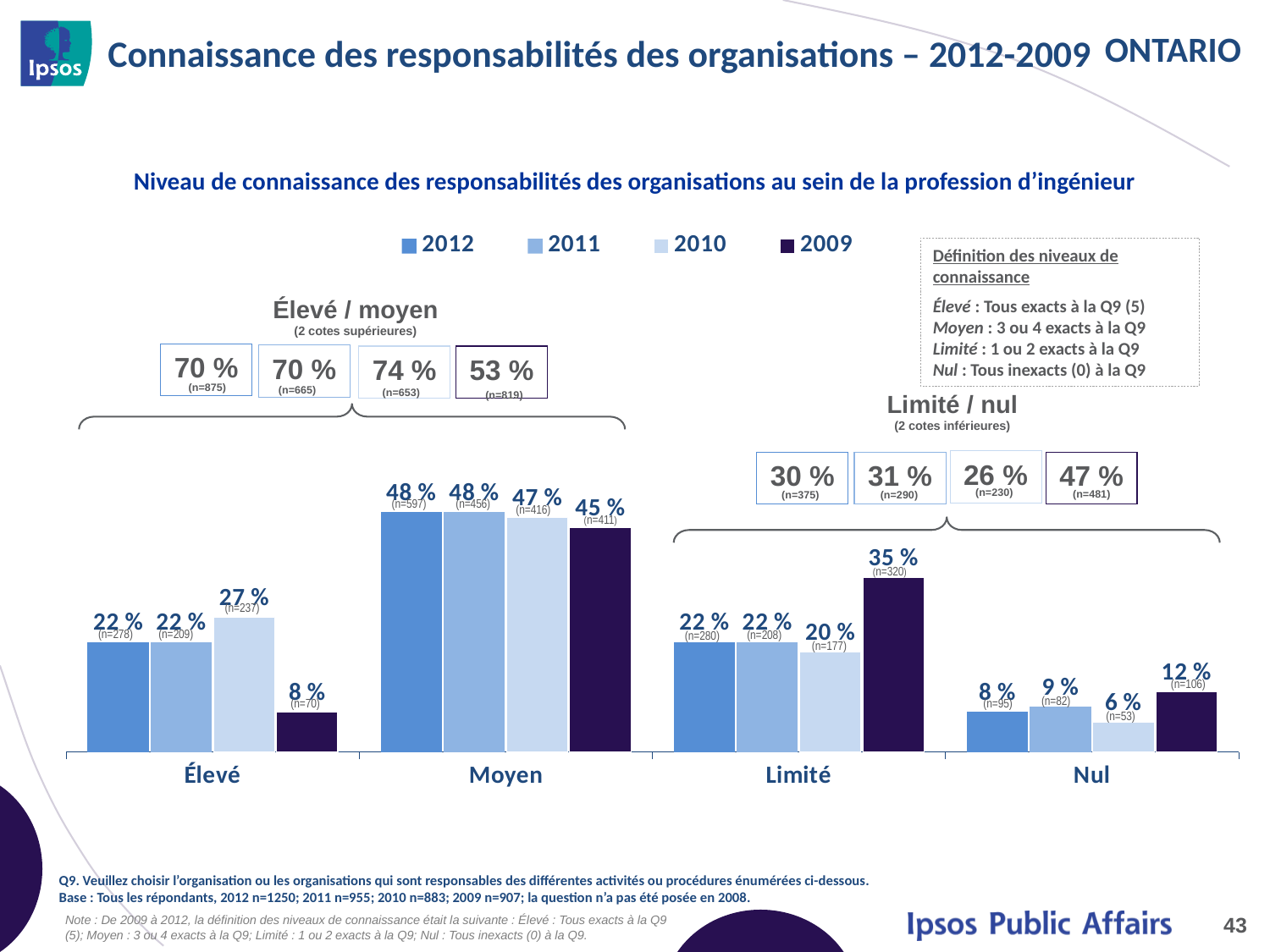
What is the difference between the 2009 and 2010 values in the Limité category? 15 % What is the 2009 value shown in the Limité / nul summary box? 47 % Which year has the highest value in the Nul category? 2009 What is the value for 2009 in the Limité category? 35 % How many series does the legend list? 4 What is the value for 2010 in the Nul category? 6 % How many categories are shown on the x axis of the chart? 4 What is the value for 2009 in the Moyen category? 45 % In the Élevé category, which is larger: the 2010 value or the 2009 value? 2010 What kind of chart is shown on the slide? Bar chart Which year has the lowest value in the Élevé category? 2009 What is the value for 2010 in the Élevé category? 27 %